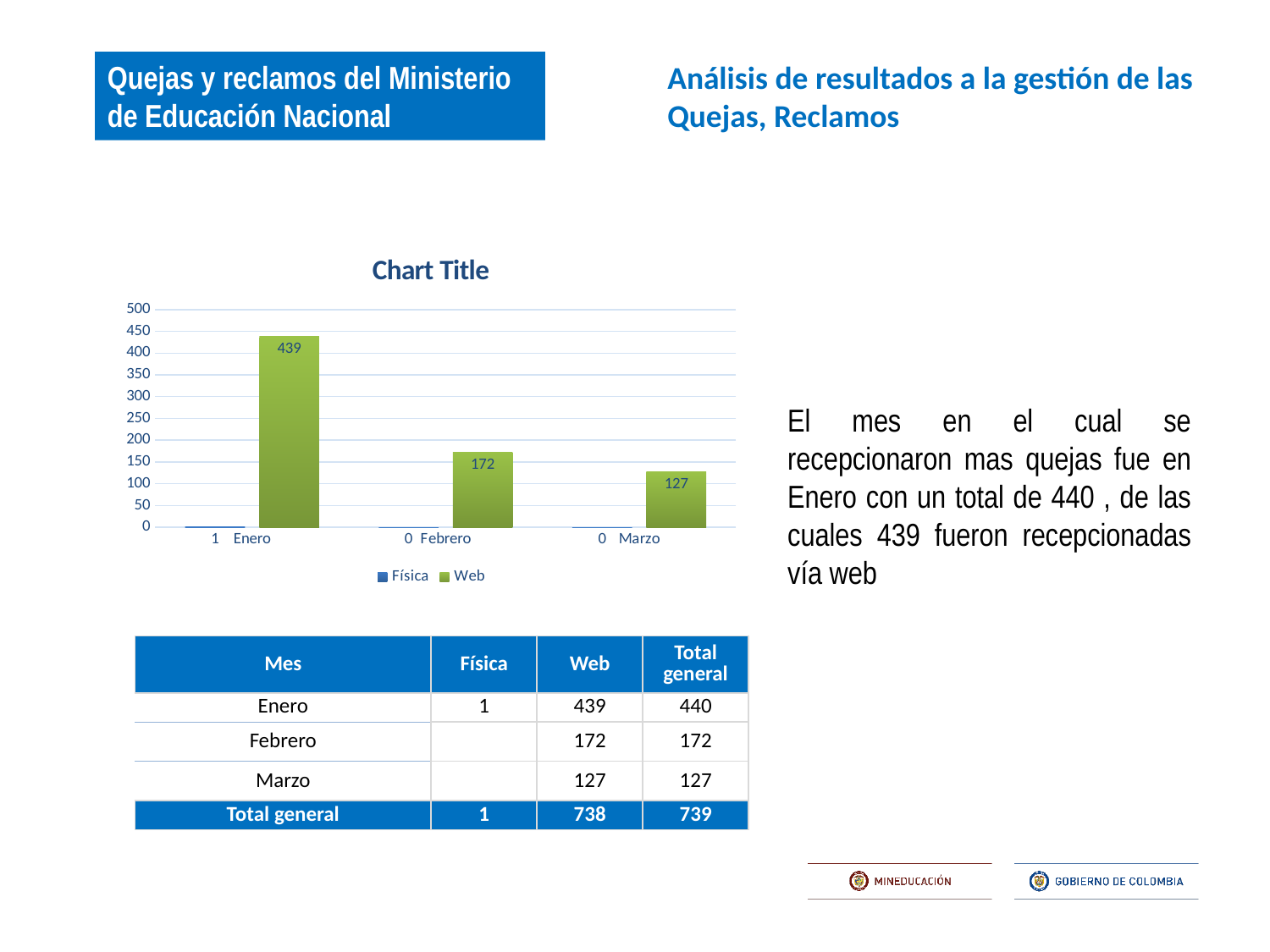
Which month has the highest Web value in the chart? Enero What is the difference between the Web values for Enero and Febrero? 267 What is the Web value for Marzo in the chart? 127 Do the Web values rise or fall from Enero to Marzo? fall What is the Web value for Enero in the chart? 439 What is the difference between the Web values for Febrero and Marzo? 45 How many months are shown on the x axis of the chart? 3 Which month has the lowest Web value in the chart? Marzo How many series does the chart legend list? 2 What type of chart is shown on the slide? bar chart Which is larger, the Web value for Febrero or for Marzo? Febrero What is the Web value for Febrero in the chart? 172